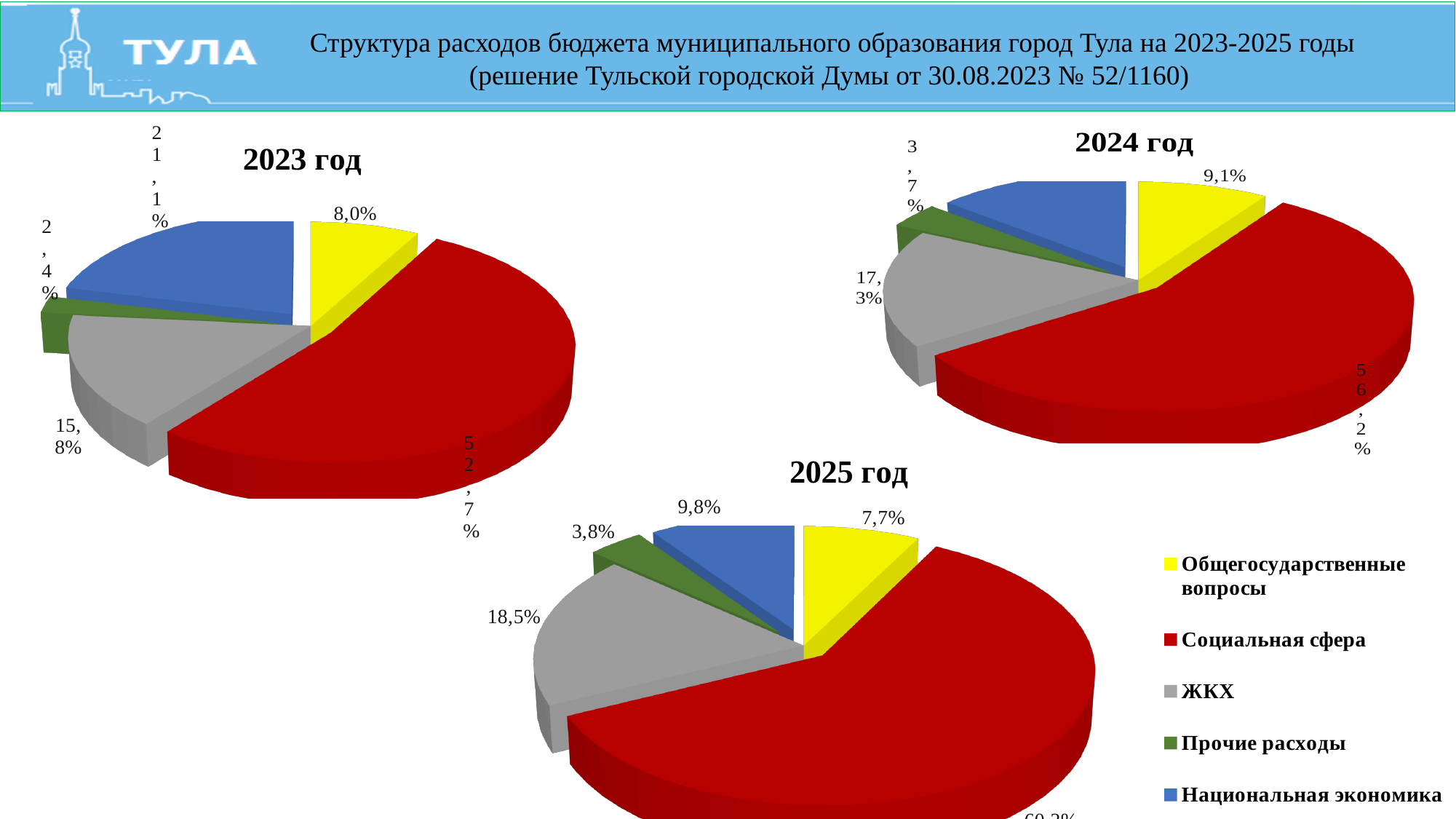
In the 2025 год chart, what share is Общегосударственные вопросы? 7,7% In the 2024 год chart, what share is ЖКХ? 17,3% In the 2023 год chart, which is larger: ЖКХ or Общегосударственные вопросы? ЖКХ In the 2024 год chart, which category has the largest share? Социальная сфера In the 2023 год chart, which category has the smallest share? Прочие расходы In the 2023 год chart, what share is Социальная сфера? 52,7% In the 2025 год chart, what share is Прочие расходы? 3,8% Which colour represents Социальная сфера in the legend? Red What kind of chart is used for each year on the slide? Pie chart In the 2023 год chart, what share is Национальная экономика? 21,1% How many categories does the legend list? 5 In the 2025 год chart, what is the difference between the shares of ЖКХ and Национальная экономика? 8,7%